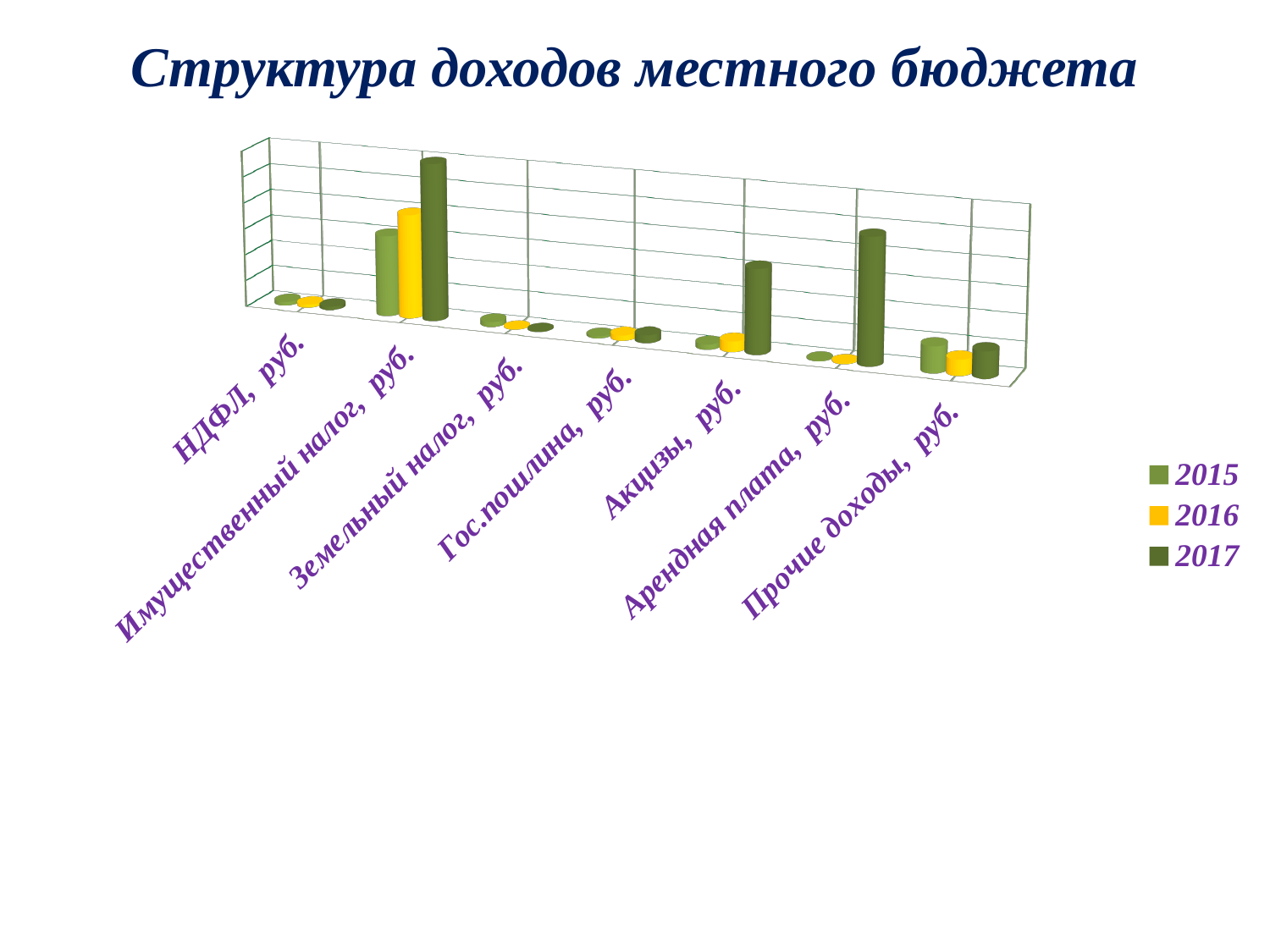
For Имущественный налог, руб., which year has the larger value: 2015 or 2017? 2017 What kind of chart is shown on the slide? Bar chart Which years are listed in the chart legend? 2015, 2016, 2017 Which category has the highest value for 2016? Имущественный налог, руб. Which category has the highest value for 2015? Имущественный налог, руб. For 2017, which category has the larger value: Акцизы, руб. or Прочие доходы, руб.? Акцизы, руб. Which category has the highest value for 2017? Имущественный налог, руб. For Арендная плата, руб., which year has the larger value: 2015 or 2017? 2017 How many series does the chart legend list? 3 What is the title of the chart on the slide? Структура доходов местного бюджета How many income categories are shown on the x axis of the chart? 7